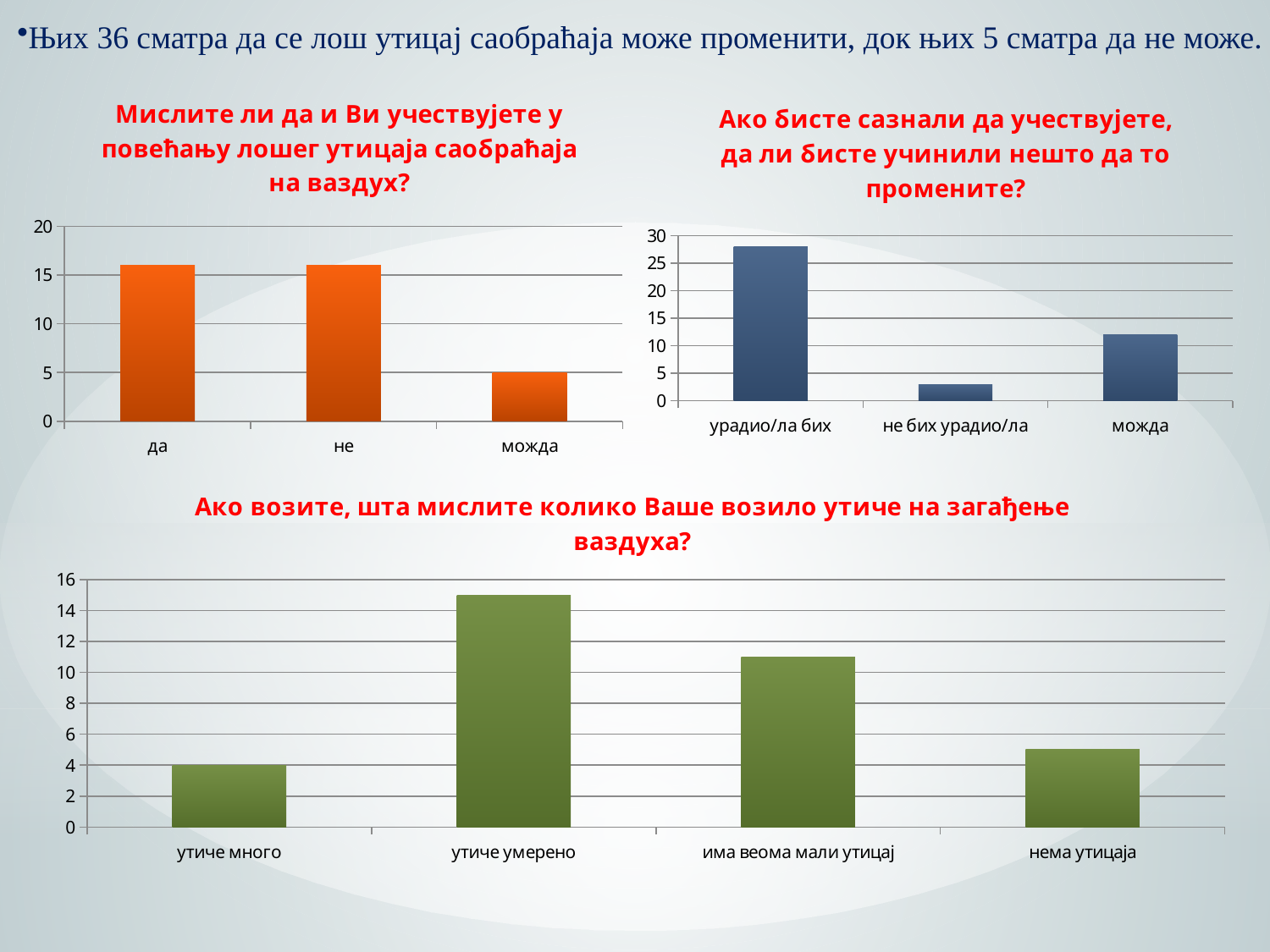
In the bottom chart titled "Ако возите, шта мислите колико Ваше возило утиче на загађење ваздуха?", which category has the highest value? утиче умерено In the bottom chart, how many categories are shown on the x axis? 4 In the top-right chart, which is larger: the value for "урадио/ла бих" or the value for "можда"? урадио/ла бих In the top-left chart, is the value for "да" greater or less than 15? greater In the top-right chart, is the value for "можда" greater or less than 10? greater In the top-right chart titled "Ако бисте сазнали да учествујете, да ли бисте учинили нешто да то промените?", which category has the highest value? урадио/ла бих In the top-right chart, which category has the lowest value? не бих урадио/ла What kind of chart is the top-left chart titled "Мислите ли да и Ви учествујете у повећању лошег утицаја саобраћаја на ваздух?"? bar chart In the top-left chart, how many categories are shown on the x axis? 3 In the bottom chart, which category has the lowest value? утиче много In the bottom chart, is the value for "има веома мали утицај" greater or less than 10? greater In the top-left chart, which category has the lowest value? можда